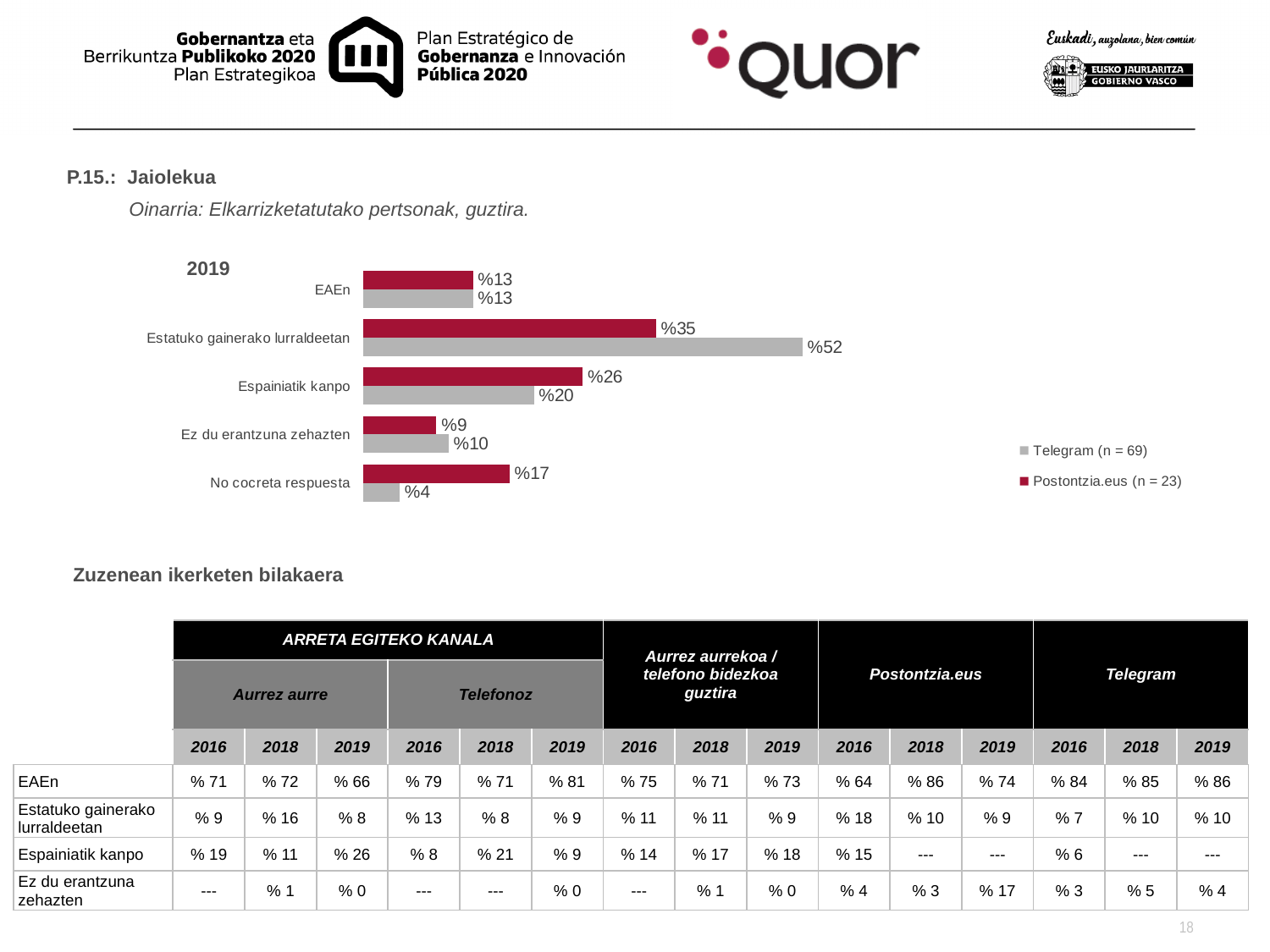
How many categories are shown in the 2019 bar chart? 5 What type of chart is used for the 2019 data? Bar chart What is the Telegram value for Estatuko gainerako lurraldeetan in the 2019 chart? %52 Which category has the highest Telegram value in the 2019 chart? Estatuko gainerako lurraldeetan What is the Postontzia.eus value for Espainiatik kanpo in the 2019 chart? %26 Which category has the lowest Postontzia.eus value in the 2019 chart? Ez du erantzuna zehazten What is the Postontzia.eus value for EAEn in the 2019 chart? %13 How many series does the legend of the 2019 chart list? 2 What is the Telegram value for No cocreta respuesta in the 2019 chart? %4 According to the legend of the 2019 chart, what is the sample size (n) for Telegram? 69 For Espainiatik kanpo in the 2019 chart, which series has the larger value, Telegram or Postontzia.eus? Postontzia.eus What is the difference between the Telegram and Postontzia.eus values for Estatuko gainerako lurraldeetan in the 2019 chart? %17